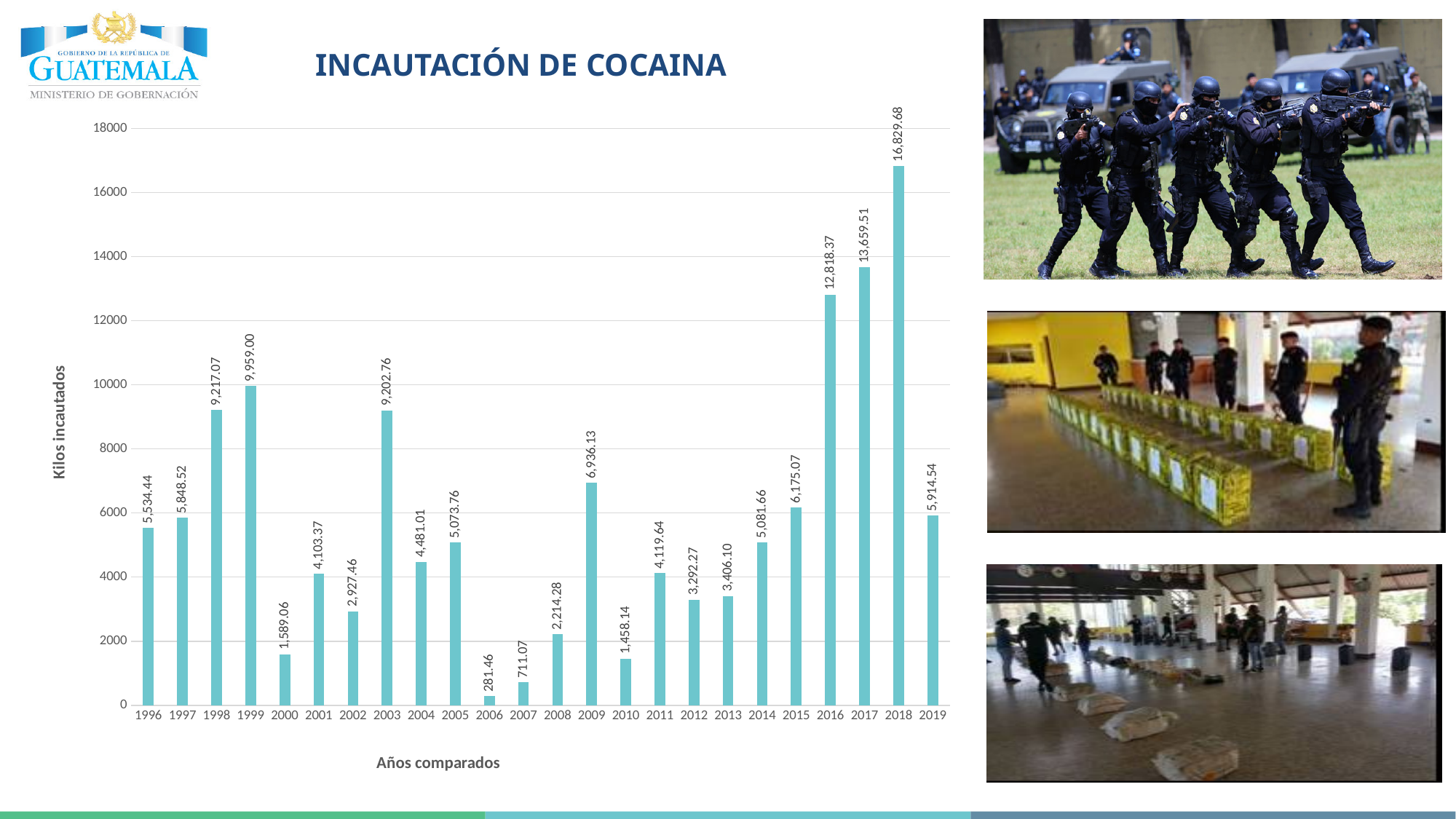
What is the difference between the values for 2018 and 2017? 3,170.17 Do the values rise or fall from 2015 to 2018? rise What is the value for 2018? 16,829.68 What is the value for 2006? 281.46 What is the value for 2019? 5,914.54 What is the value for 1999? 9,959.00 Which year has the highest value? 2018 Is the value for 2016 greater or less than 12000? greater What kind of chart is shown? bar chart Which year has the lowest value? 2006 How many years are shown on the x axis? 24 Which is larger, the value for 1999 or the value for 2009? 1999